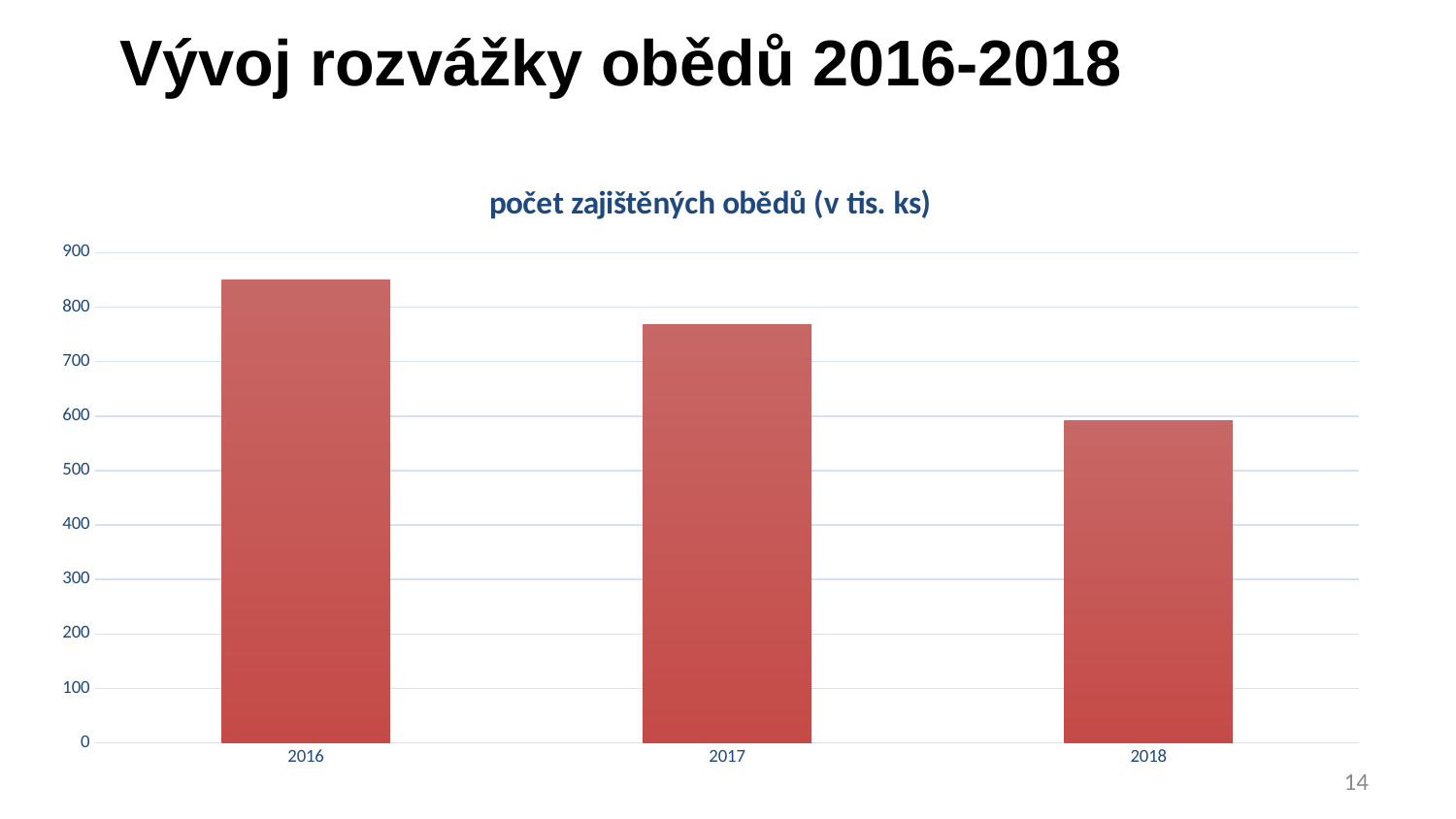
Which year has the lowest value in the chart? 2018 Do the values rise or fall from 2016 to 2018? fall What is the title of the chart? počet zajištěných obědů (v tis. ks) Is the value for 2016 greater or less than 800? greater Which is larger, the value for 2017 or the value for 2018? 2017 Is the value for 2018 greater or less than 700? less Is the value for 2018 greater or less than 500? greater What type of chart is shown on the slide? bar chart How many years (categories) are shown on the x axis of the chart? 3 Which year has the highest value in the chart? 2016